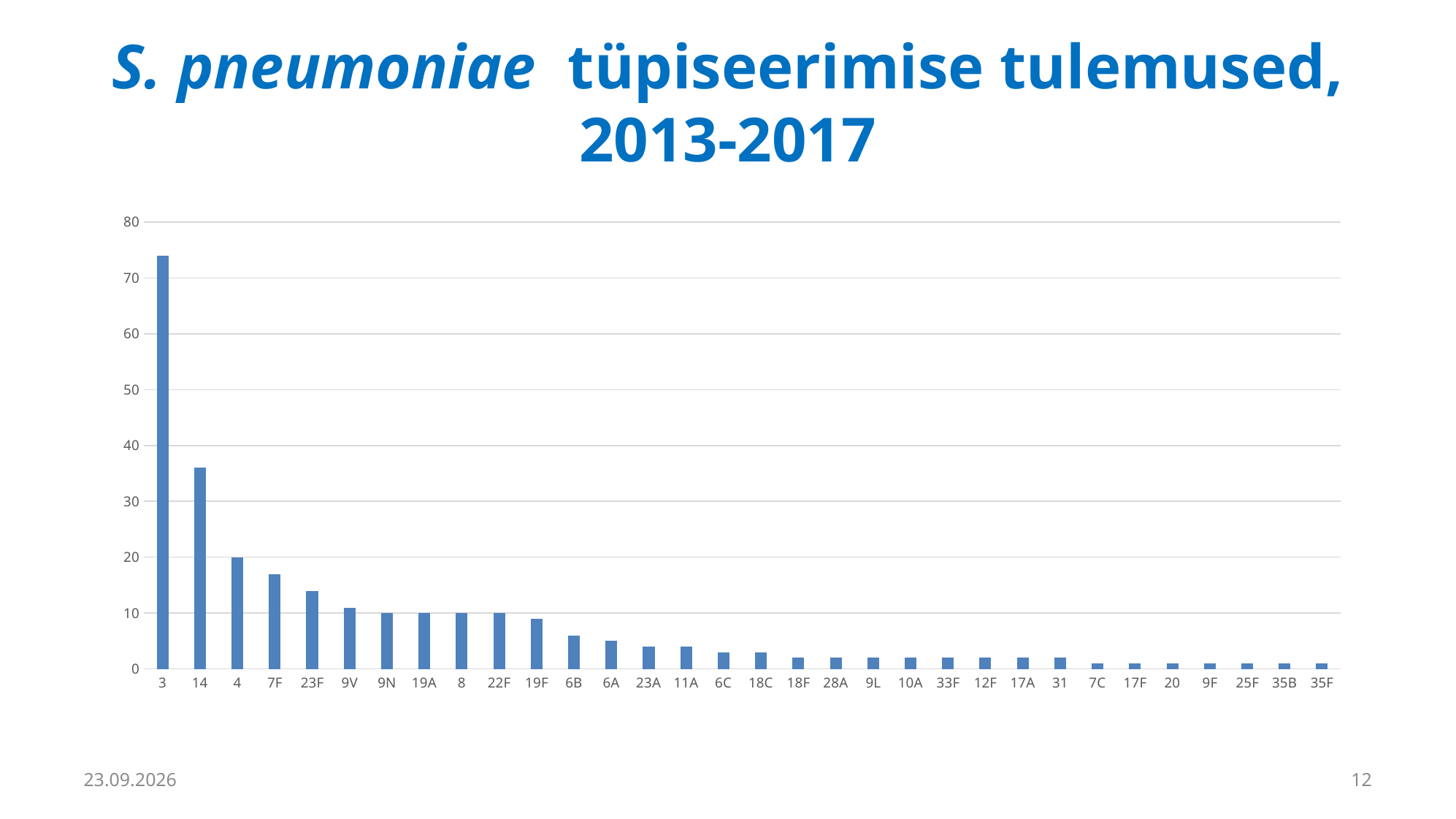
Which serotype has the highest bar in the chart? 3 What is the value for serotype 4? 20 Which has the larger value, serotype 7F or serotype 23F? 7F What kind of chart is shown on the slide? bar chart What years does the chart title say the typing results cover? 2013-2017 How many serotype categories are shown on the x axis? 32 Is the value for serotype 7F greater or less than 20? less Is the value for serotype 3 greater or less than 70? greater Do the bar values rise or fall from left to right along the x axis? fall Is the value for serotype 6B greater or less than 10? less Which has the larger value, serotype 14 or serotype 4? 14